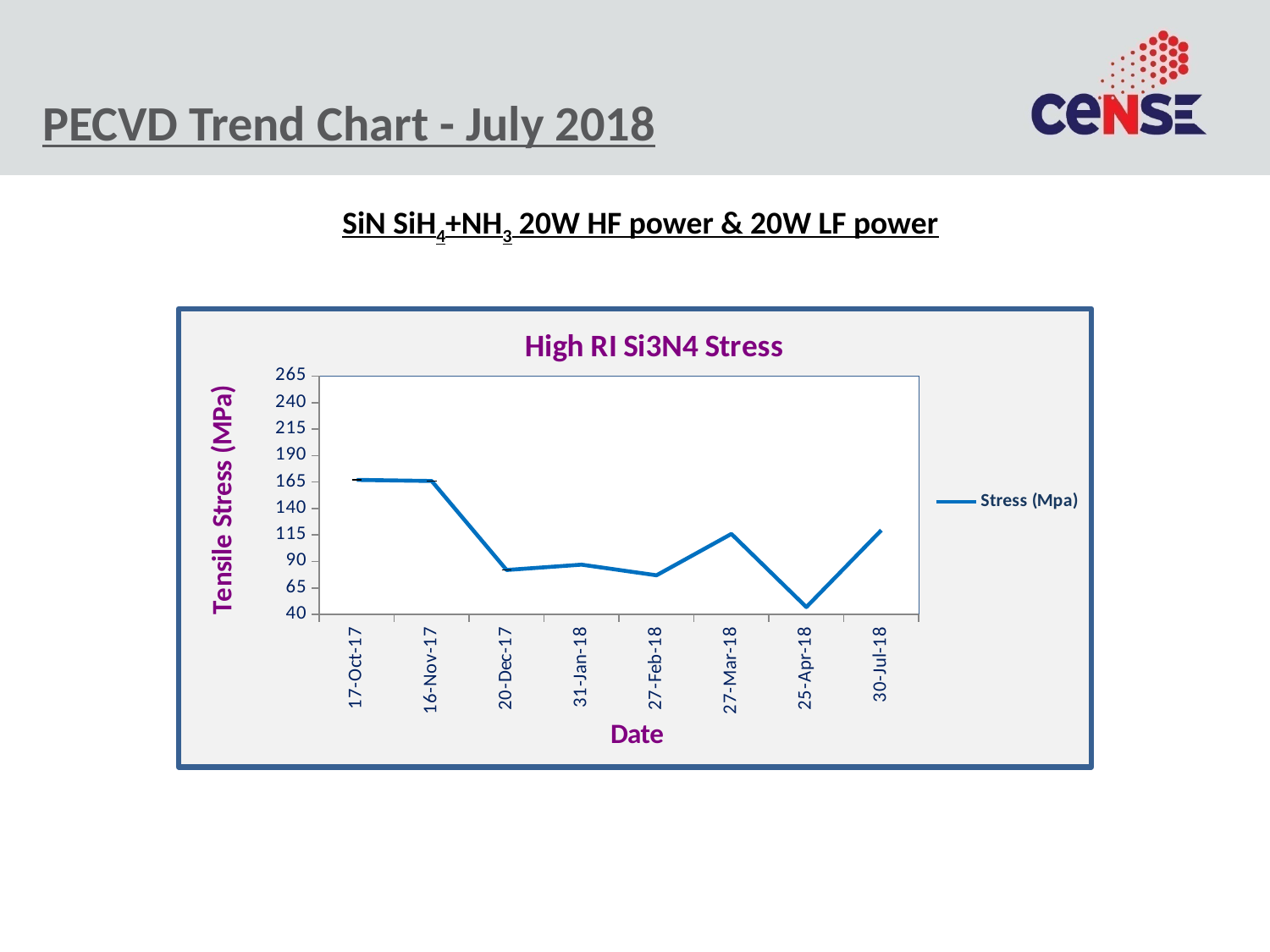
Does the stress value rise or fall from 25-Apr-18 to 30-Jul-18? rise Is the stress value for 17-Oct-17 greater or less than 140? greater What kind of chart is shown on the slide? line chart Is the stress value for 27-Mar-18 greater or less than 90? greater How many dates are plotted along the x axis of the chart? 8 How many series does the chart legend list? 1 Is the stress value for 25-Apr-18 greater or less than 65? less On which date is the stress value lowest? 25-Apr-18 What is the title of the chart? High RI Si3N4 Stress Which has the larger stress value, 16-Nov-17 or 27-Feb-18? 16-Nov-17 What is the label of the y axis? Tensile Stress (MPa)